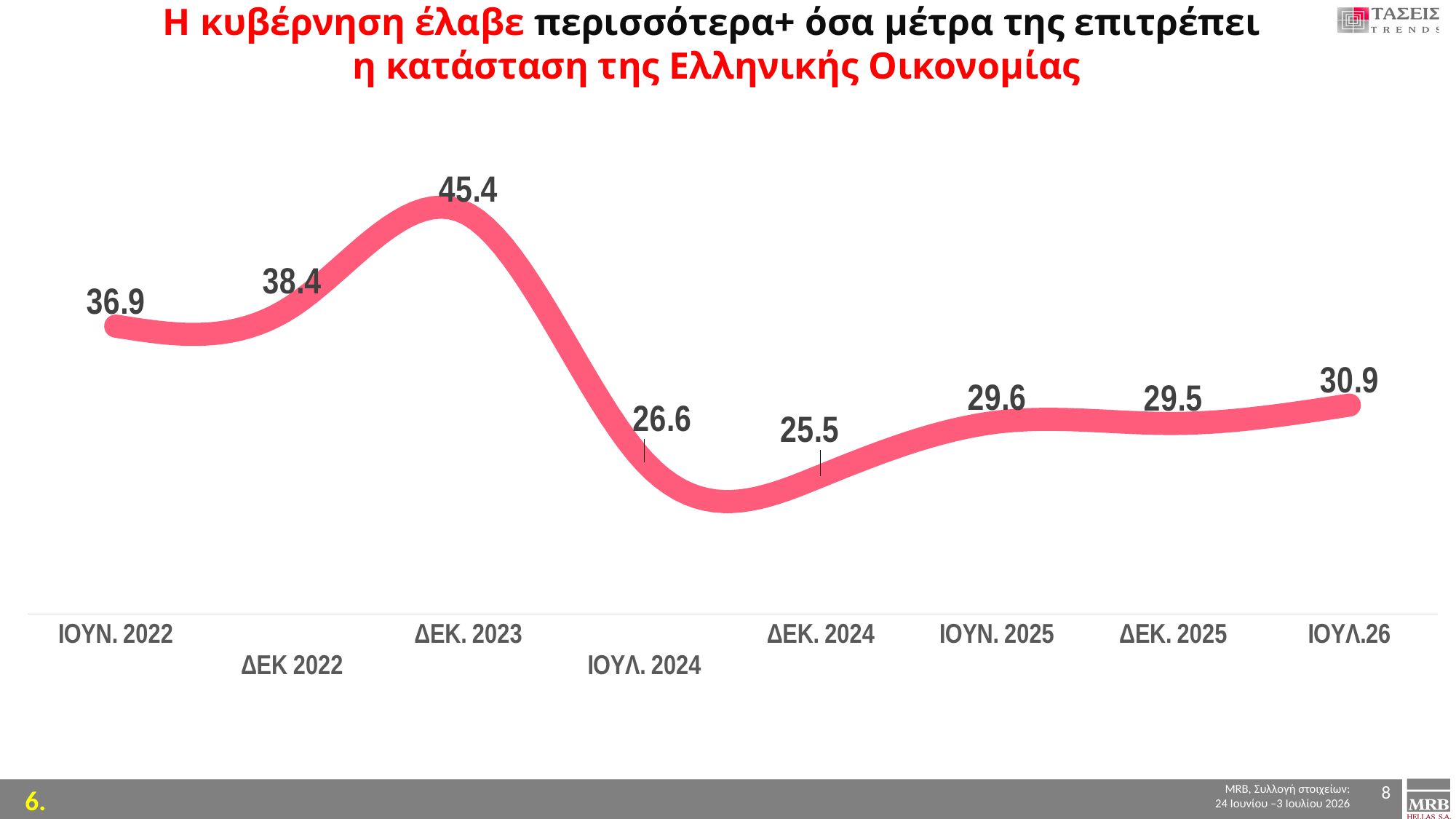
Which time point has the highest value? ΔΕΚ. 2023 Which time point has the lowest value? ΔΕΚ. 2024 What kind of chart is shown on the slide? line chart How many time points are plotted on the chart? 8 What is the difference between the values for ΔΕΚ. 2023 and ΙΟΥΛ. 2024? 18.8 What is the value for ΔΕΚ. 2023? 45.4 What is the value for ΙΟΥΛ.26? 30.9 What is the value for ΙΟΥΝ. 2022? 36.9 What is the value for ΔΕΚ. 2024? 25.5 What is the difference between the values for ΔΕΚ 2022 and ΙΟΥΝ. 2022? 1.5 Which is larger, the value for ΙΟΥΝ. 2025 or the value for ΔΕΚ. 2024? ΙΟΥΝ. 2025 Does the value rise or fall from ΔΕΚ. 2023 to ΙΟΥΛ. 2024? fall